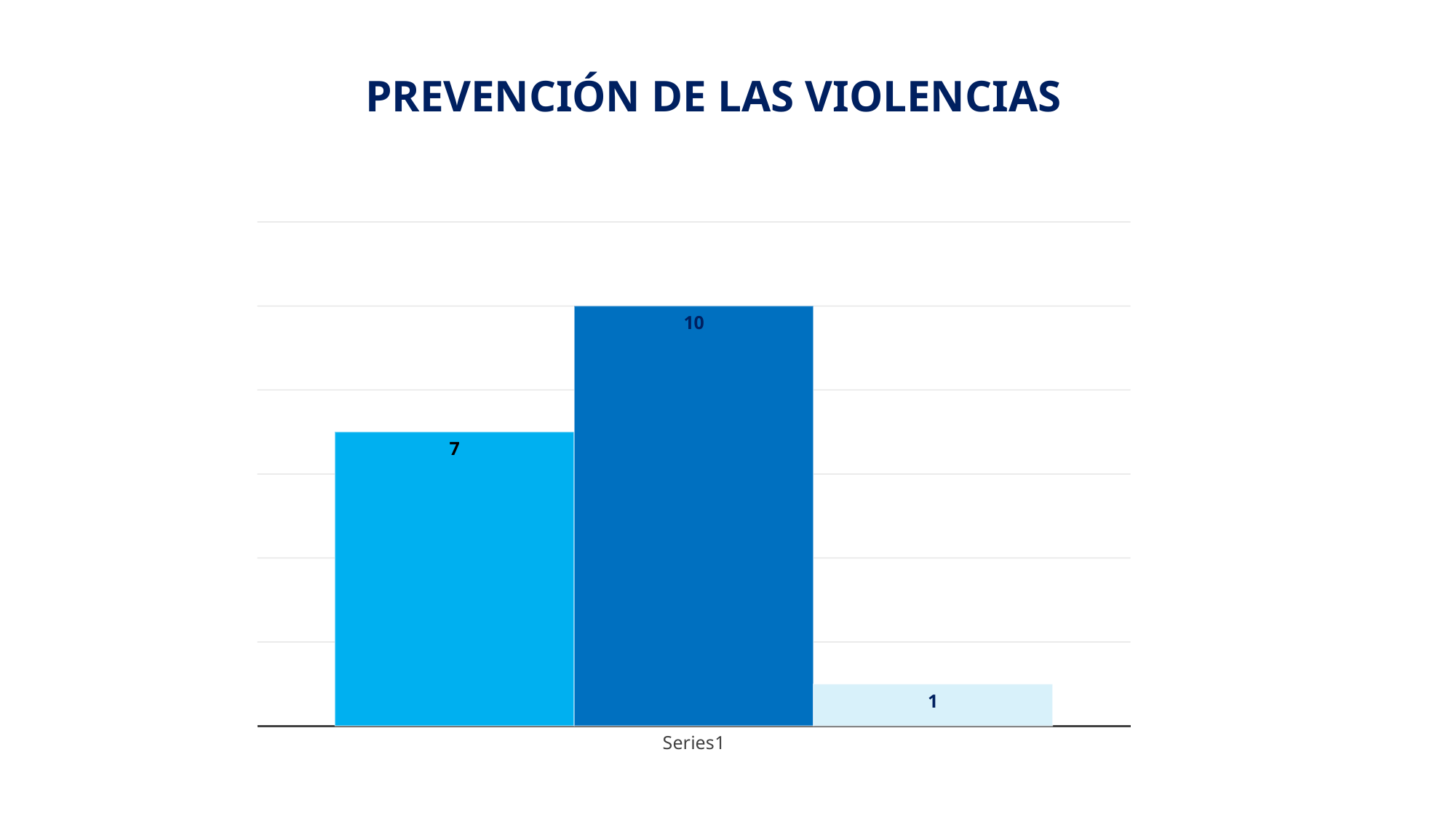
What is the title of the chart? PREVENCIÓN DE LAS VIOLENCIAS What kind of chart is shown on the slide? bar chart Which bar has the lowest value? the rightmost (pale blue) bar, 1 What is the value of the rightmost (pale blue) bar? 1 Which bar has the highest value? the middle (dark blue) bar, 10 How many bars are plotted in the chart? 3 Which is larger, the leftmost bar or the middle bar? the middle bar What is the value of the middle (dark blue) bar? 10 What is the value of the leftmost (light blue) bar? 7 What category label is shown on the x axis? Series1 What is the difference between the middle bar and the leftmost bar? 3 What is the difference between the leftmost bar and the rightmost bar? 6